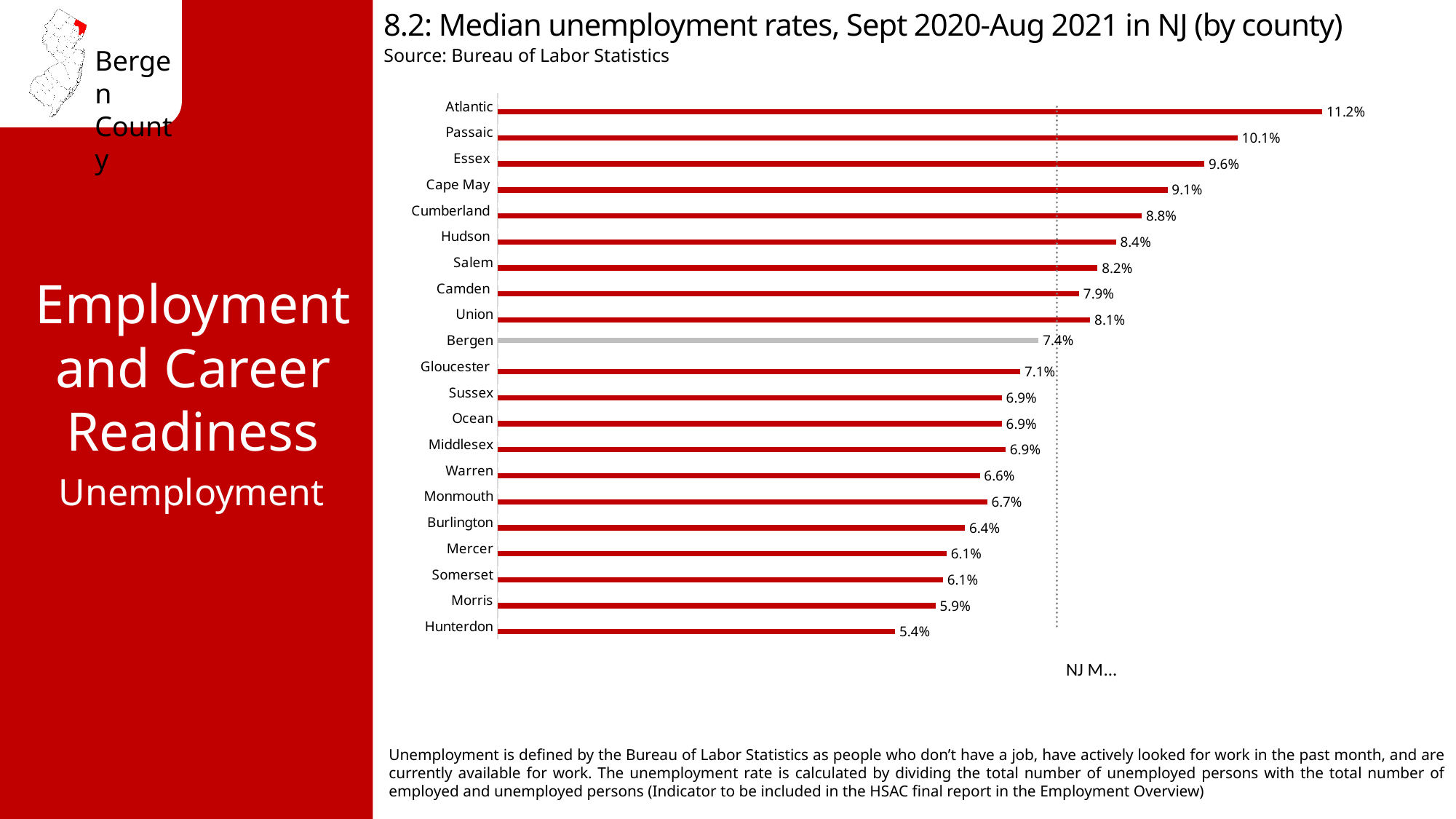
Which county has a higher median unemployment rate, Essex or Cape May? Essex What is the difference between the median unemployment rates of Atlantic and Hunterdon counties? 5.8 percentage points What is the difference between the median unemployment rates of Passaic and Bergen counties? 2.7 percentage points What is the median unemployment rate shown for Hudson County? 8.4% Which county has the lowest median unemployment rate on the chart? Hunterdon How many counties are shown on the chart? 21 Which county has the highest median unemployment rate on the chart? Atlantic What is the median unemployment rate shown for Bergen County? 7.4% What type of chart is used to show the median unemployment rates? Bar chart Which county's bar is coloured grey instead of red? Bergen Which county has a higher median unemployment rate, Camden or Union? Union What is the median unemployment rate shown for Morris County? 5.9%